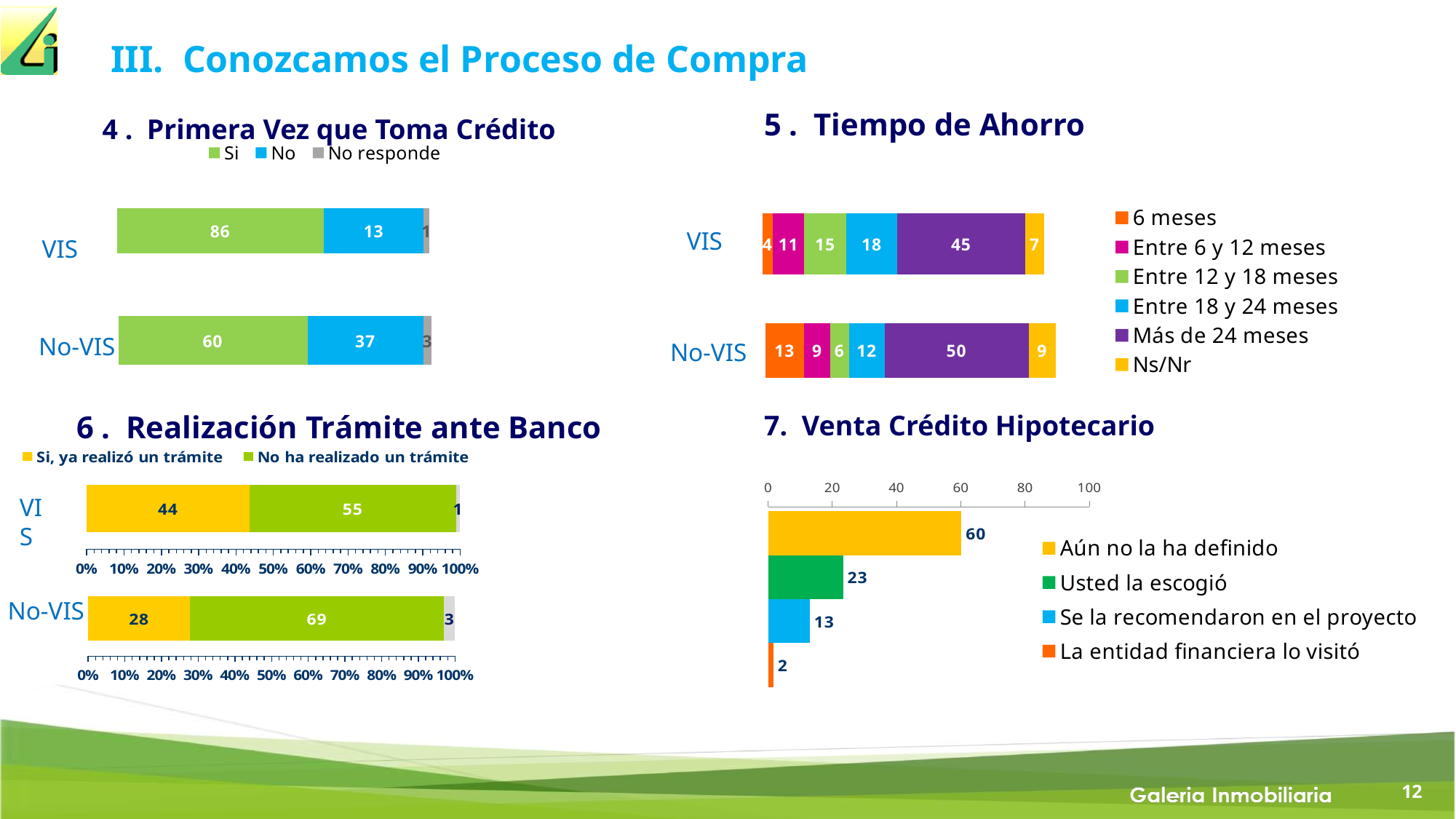
In the chart '5. Tiempo de Ahorro', what is the value of 'Más de 24 meses' for No-VIS? 50 In the chart '4. Primera Vez que Toma Crédito', what is the value of 'No' for No-VIS? 37 In the chart '4. Primera Vez que Toma Crédito', what is the difference between the 'Si' values for VIS and No-VIS? 26 In the chart '6. Realización Trámite ante Banco', what is the value of 'Si, ya realizó un trámite' for No-VIS? 28 In the chart '4. Primera Vez que Toma Crédito', what is the value of 'Si' for VIS? 86 What kind of chart is '7. Venta Crédito Hipotecario'? Bar chart In the chart '6. Realización Trámite ante Banco', what is the value of 'No ha realizado un trámite' for VIS? 55 In the chart '5. Tiempo de Ahorro', which is larger for No-VIS: '6 meses' or 'Entre 6 y 12 meses'? 6 meses In the chart '5. Tiempo de Ahorro', which category has the highest value for VIS? Más de 24 meses In the chart '5. Tiempo de Ahorro', how many series does the legend list? 6 In the chart '7. Venta Crédito Hipotecario', what is the value for 'Usted la escogió'? 23 In the chart '7. Venta Crédito Hipotecario', which category has the lowest value? La entidad financiera lo visitó